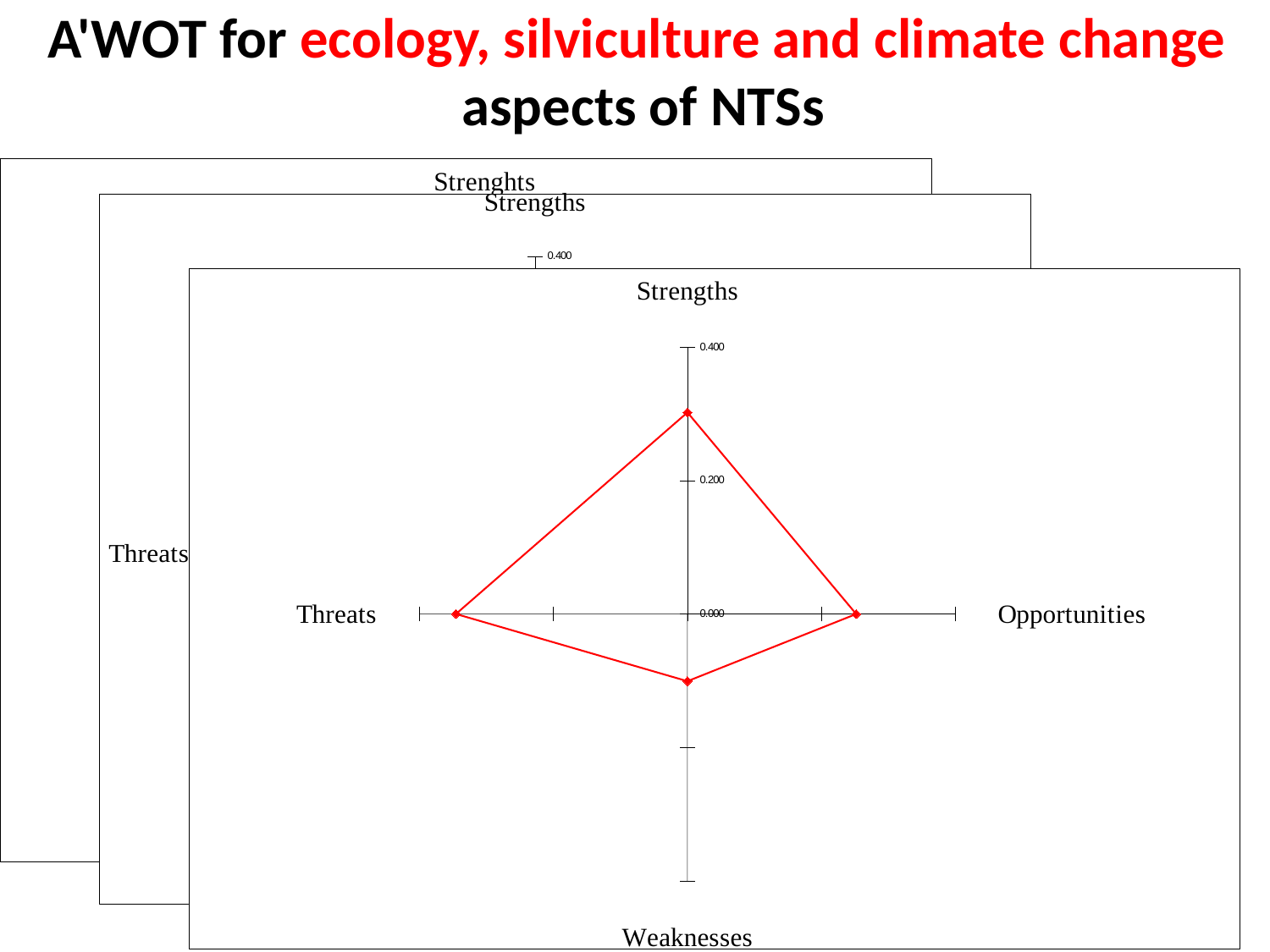
How many categories (axes) does the radar chart have? 4 Which is larger, the value for Opportunities or the value for Weaknesses? Opportunities What kind of chart is shown on the slide? radar chart Which category label appears at the bottom of the radar chart? Weaknesses Is the value for Threats greater or less than 0.200? greater Which category has the lowest value on the radar chart? Weaknesses Is the value for Opportunities greater or less than 0.200? greater Is the value for Weaknesses greater or less than 0.200? less Which is larger, the value for Strengths or the value for Weaknesses? Strengths What is the highest tick value shown on the radar chart's axis? 0.400